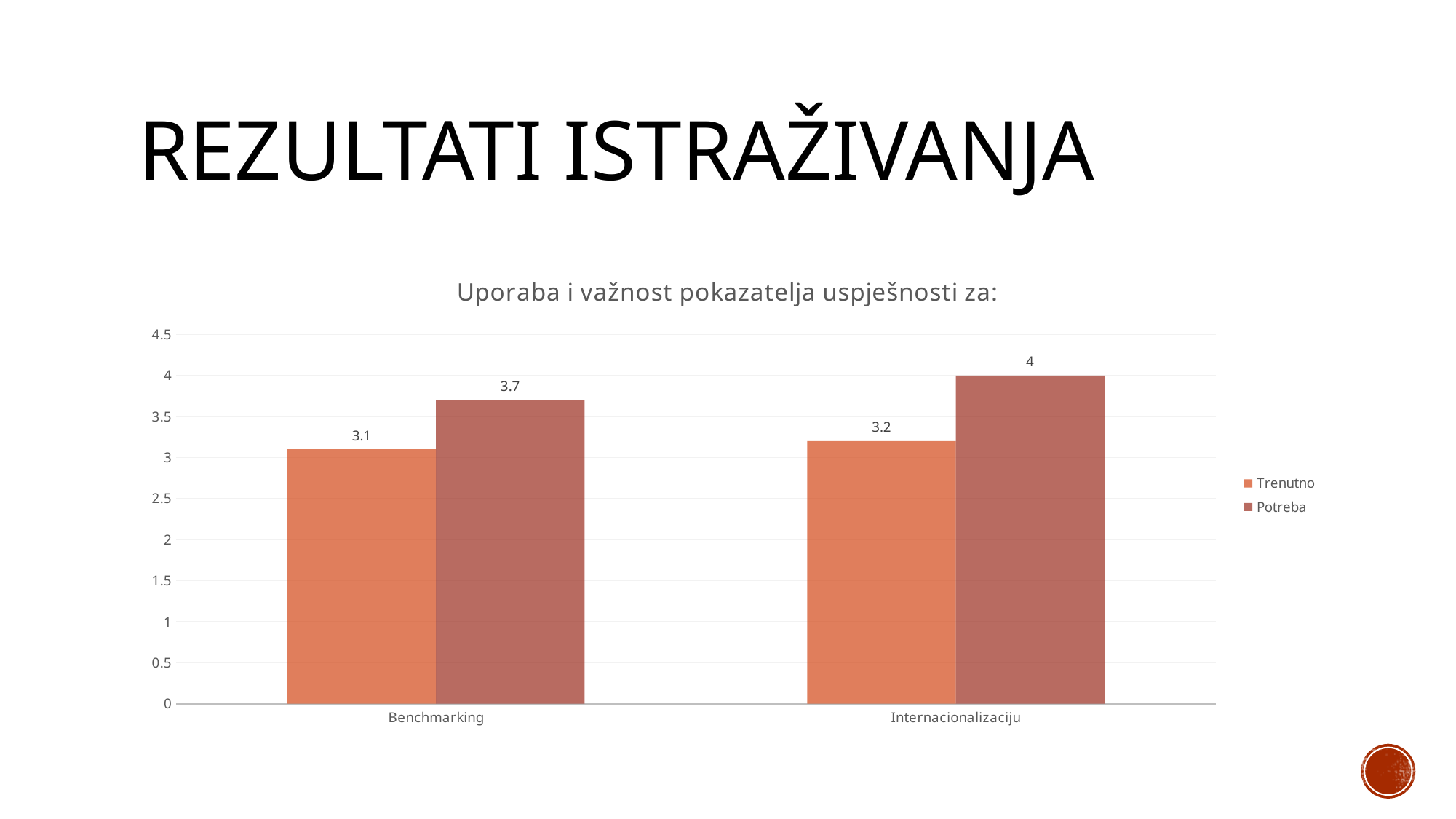
Which category has the lowest Trenutno value? Benchmarking Which is larger for Benchmarking, Trenutno or Potreba? Potreba What is the Potreba value for Internacionalizaciju? 4 Which category has the highest Potreba value? Internacionalizaciju What is the Trenutno value for Benchmarking? 3.1 What is the Trenutno value for Internacionalizaciju? 3.2 What is the difference between the Potreba and Trenutno values for Internacionalizaciju? 0.8 How many series does the legend list? 2 How many categories are shown on the x axis? 2 What type of chart is shown on the slide? Bar chart What is the Potreba value for Benchmarking? 3.7 What is the difference between the Potreba and Trenutno values for Benchmarking? 0.6